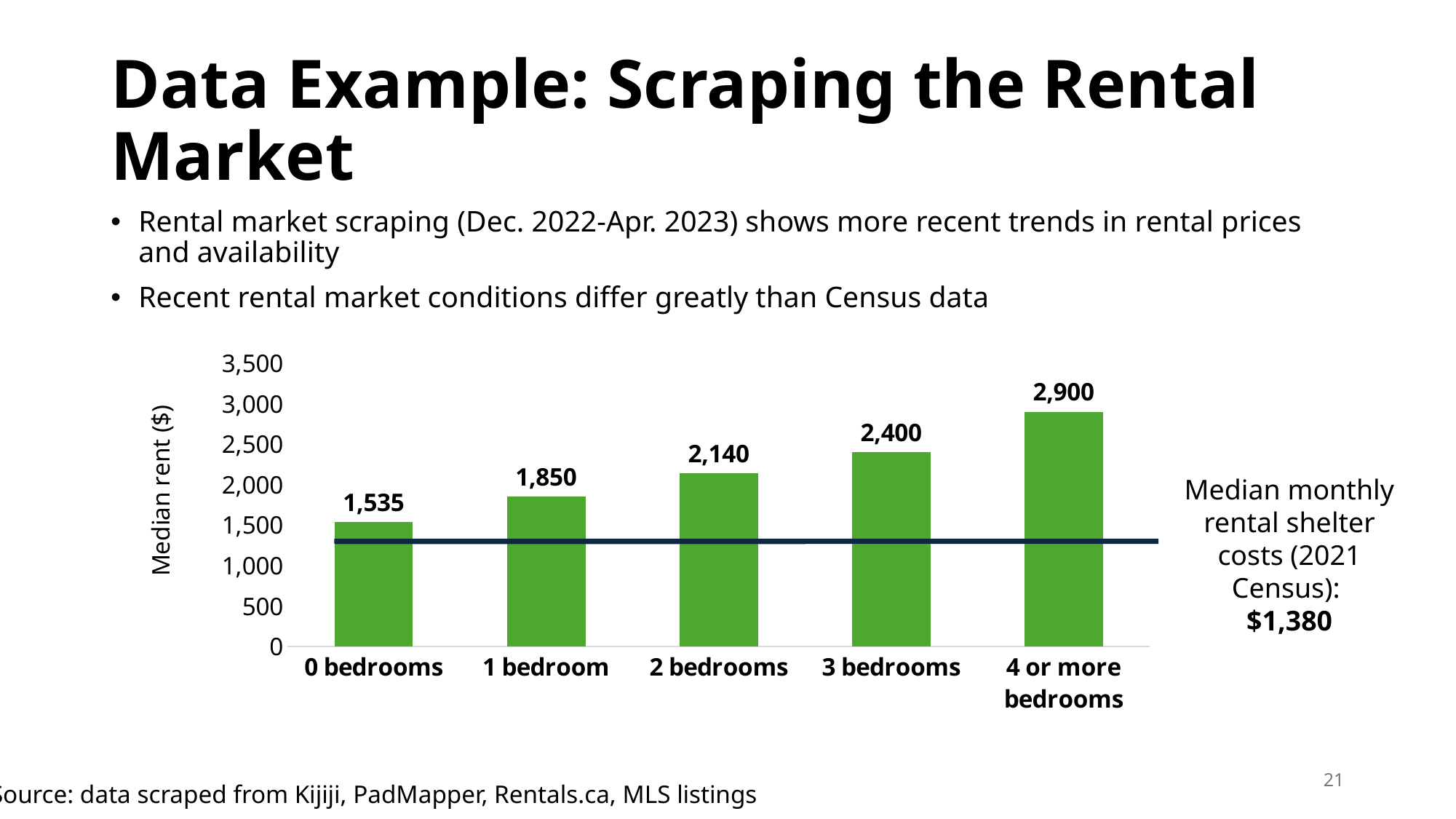
What is the median rent for 4 or more bedrooms? 2,900 Which has a higher median rent, 1 bedroom or 2 bedrooms? 2 bedrooms What value does the horizontal line on the chart represent for median monthly rental shelter costs (2021 Census)? $1,380 How many bedroom categories are shown on the chart? 5 What kind of chart is shown on the slide? Bar chart What is the median rent for 2 bedrooms? 2,140 What is the median rent for 0 bedrooms? 1,535 Which bedroom category has the highest median rent? 4 or more bedrooms What is the difference in median rent between 3 bedrooms and 1 bedroom? 550 Do the median rent values rise or fall as the number of bedrooms increases? Rise What is the difference in median rent between 4 or more bedrooms and 0 bedrooms? 1,365 Which bedroom category has the lowest median rent? 0 bedrooms